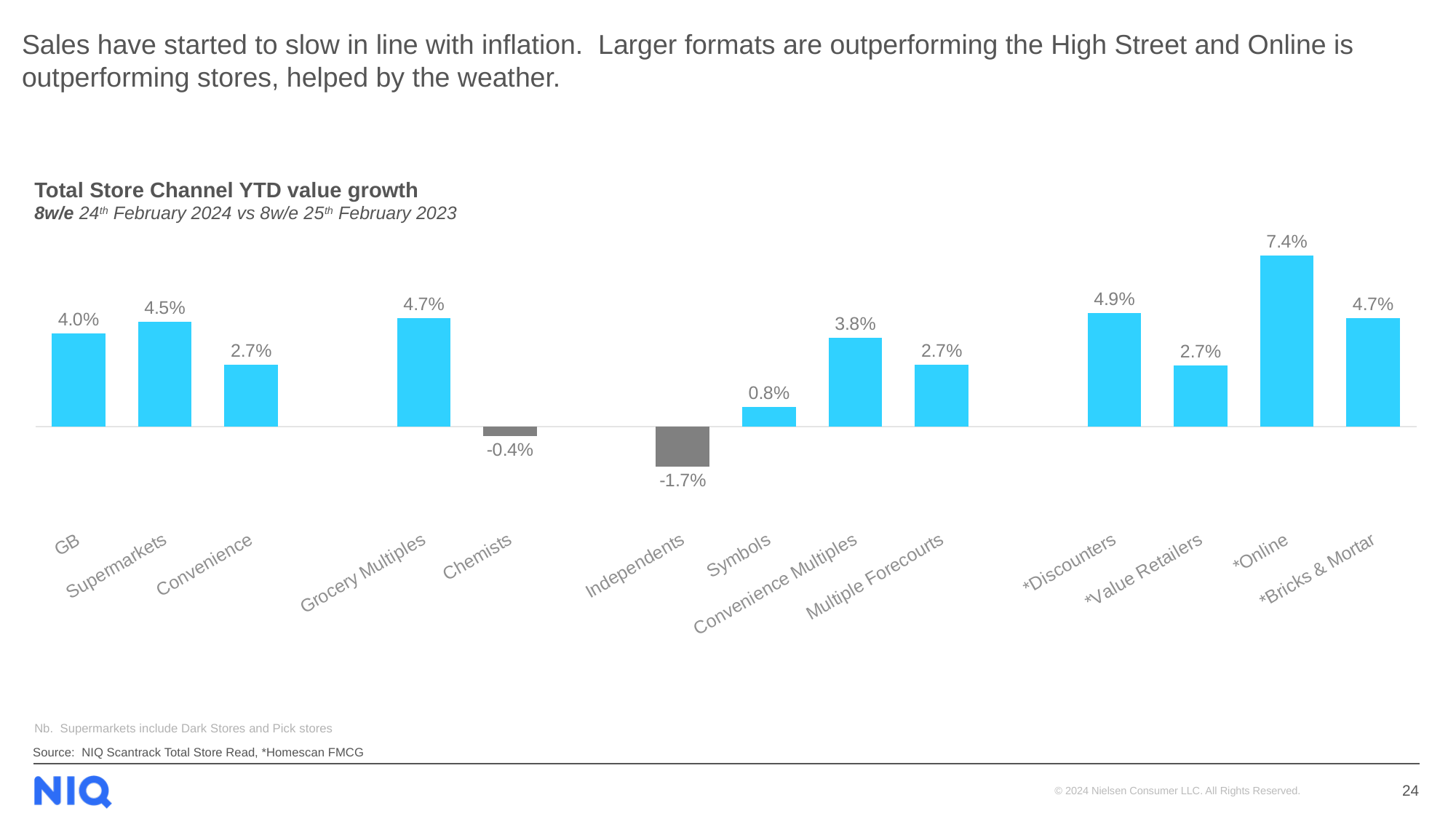
What is the YTD value growth for Convenience Multiples? 3.8% How many channels are shown in the chart? 13 What is the YTD value growth for Supermarkets? 4.5% What is the difference in YTD value growth between *Online and *Bricks & Mortar? 2.7 percentage points Which channel has the highest YTD value growth? *Online What is the title of the chart? Total Store Channel YTD value growth What kind of chart is used to show Total Store Channel YTD value growth? Bar chart Which has higher YTD value growth, *Discounters or Symbols? *Discounters Which channel has the lowest YTD value growth? Independents What is the YTD value growth for Chemists? -0.4% What is the YTD value growth for Independents? -1.7% What colour are the bars for channels with negative growth? Grey